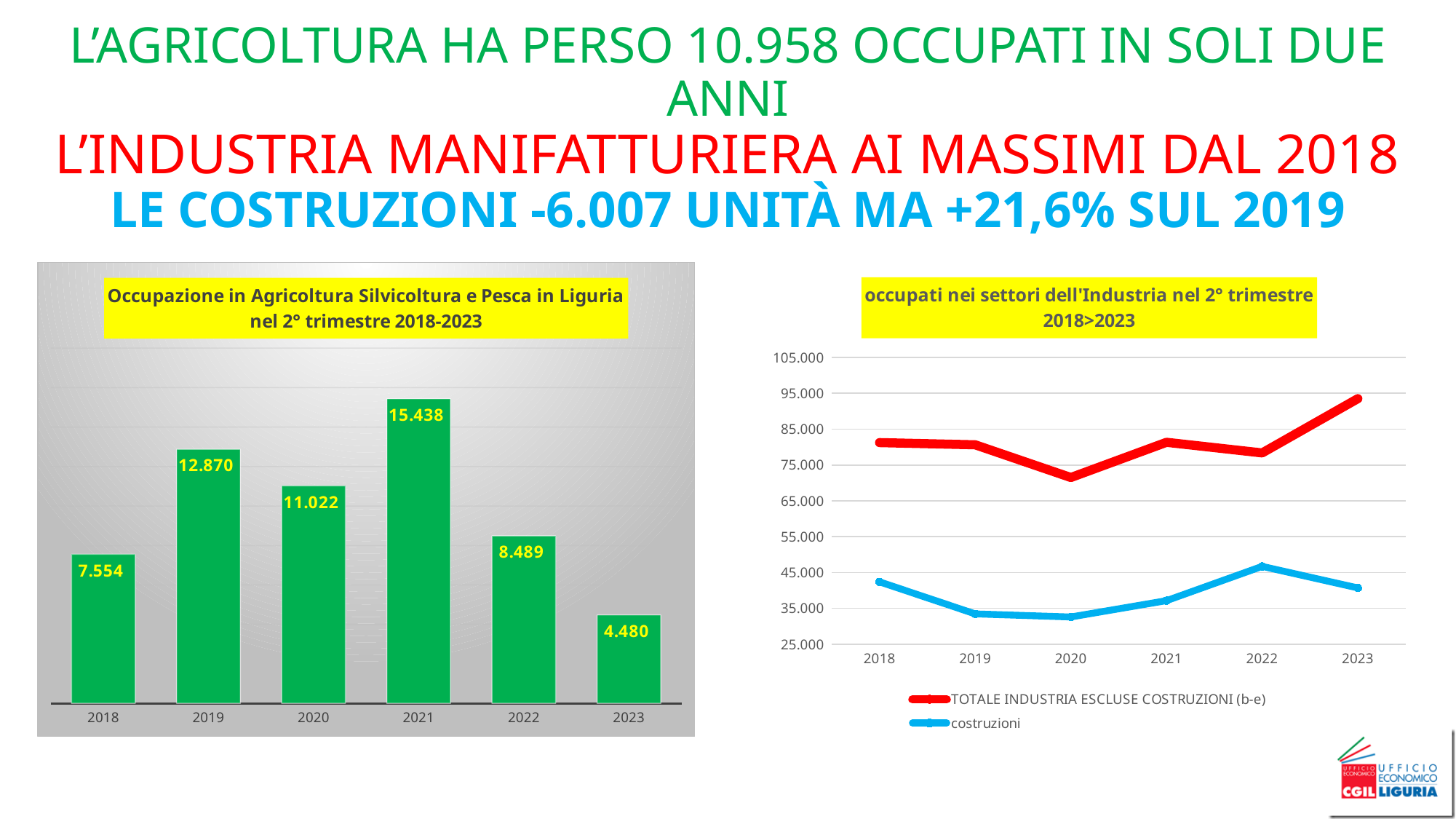
In the left chart (Occupazione in Agricoltura Silvicoltura e Pesca in Liguria), how many years are shown? 6 In the left chart (Occupazione in Agricoltura Silvicoltura e Pesca in Liguria), what is the value for 2023? 4.480 In the right chart (occupati nei settori dell'Industria nel 2° trimestre 2018>2023), is the value for TOTALE INDUSTRIA ESCLUSE COSTRUZIONI (b-e) in 2023 greater or less than 85.000? greater What kind of chart is the left chart (Occupazione in Agricoltura Silvicoltura e Pesca in Liguria)? Bar chart In the right chart (occupati nei settori dell'Industria nel 2° trimestre 2018>2023), is the value for costruzioni in 2020 greater or less than 35.000? less In the left chart (Occupazione in Agricoltura Silvicoltura e Pesca in Liguria), what is the difference between the 2021 and 2023 values? 10.958 In the left chart (Occupazione in Agricoltura Silvicoltura e Pesca in Liguria), which is larger, the value for 2019 or the value for 2020? 2019 In the left chart (Occupazione in Agricoltura Silvicoltura e Pesca in Liguria), which year has the lowest value? 2023 In the right chart (occupati nei settori dell'Industria nel 2° trimestre 2018>2023), what colour is the costruzioni line? Blue In the left chart (Occupazione in Agricoltura Silvicoltura e Pesca in Liguria), which year has the highest value? 2021 In the left chart (Occupazione in Agricoltura Silvicoltura e Pesca in Liguria), what is the value for 2021? 15.438 In the right chart (occupati nei settori dell'Industria nel 2° trimestre 2018>2023), how many series does the legend list? 2